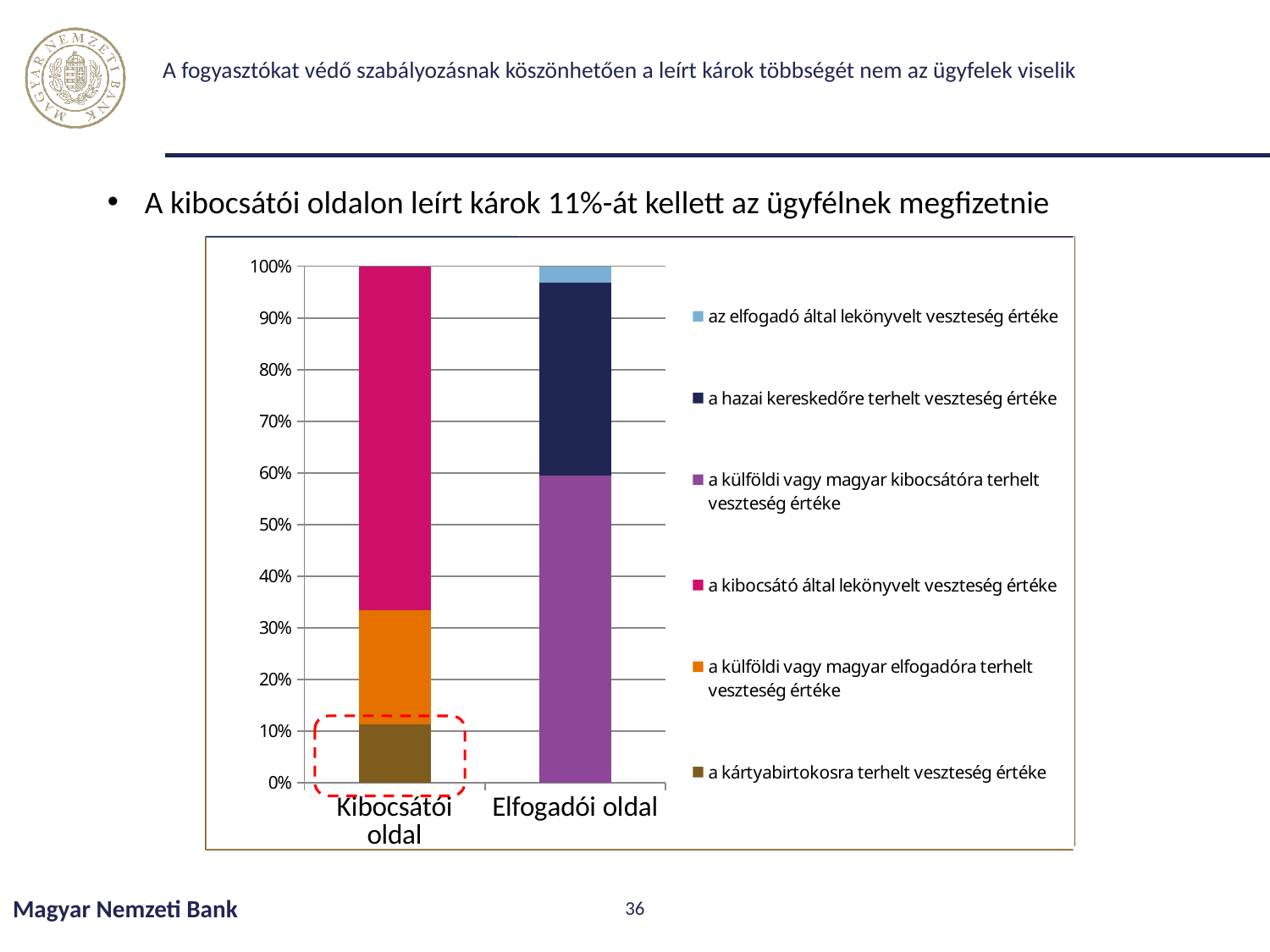
Is the share of 'a kibocsátó által lekönyvelt veszteség értéke' in the Kibocsátói oldal bar greater or less than 60%? greater What kind of chart is shown on the slide? Stacked bar chart What are the two categories on the x axis of the chart? Kibocsátói oldal and Elfogadói oldal Which legend entry is shown in light blue? az elfogadó által lekönyvelt veszteség értéke What is the total height of the Kibocsátói oldal stacked bar? 100% Is the share of 'az elfogadó által lekönyvelt veszteség értéke' in the Elfogadói oldal bar greater or less than 10%? less How many series does the chart legend list? 6 In the Kibocsátói oldal bar, which segment is larger: 'a kibocsátó által lekönyvelt veszteség értéke' or 'a külföldi vagy magyar elfogadóra terhelt veszteség értéke'? a kibocsátó által lekönyvelt veszteség értéke Is the share of 'a külföldi vagy magyar kibocsátóra terhelt veszteség értéke' in the Elfogadói oldal bar greater or less than 50%? greater How many categories are shown on the x axis of the chart? 2 In the Elfogadói oldal bar, which segment is larger: 'a hazai kereskedőre terhelt veszteség értéke' or 'az elfogadó által lekönyvelt veszteség értéke'? a hazai kereskedőre terhelt veszteség értéke According to the slide, what share of the losses written off on the issuer side (Kibocsátói oldal) had to be paid by the customer (a kártyabirtokosra terhelt veszteség értéke)? 11%